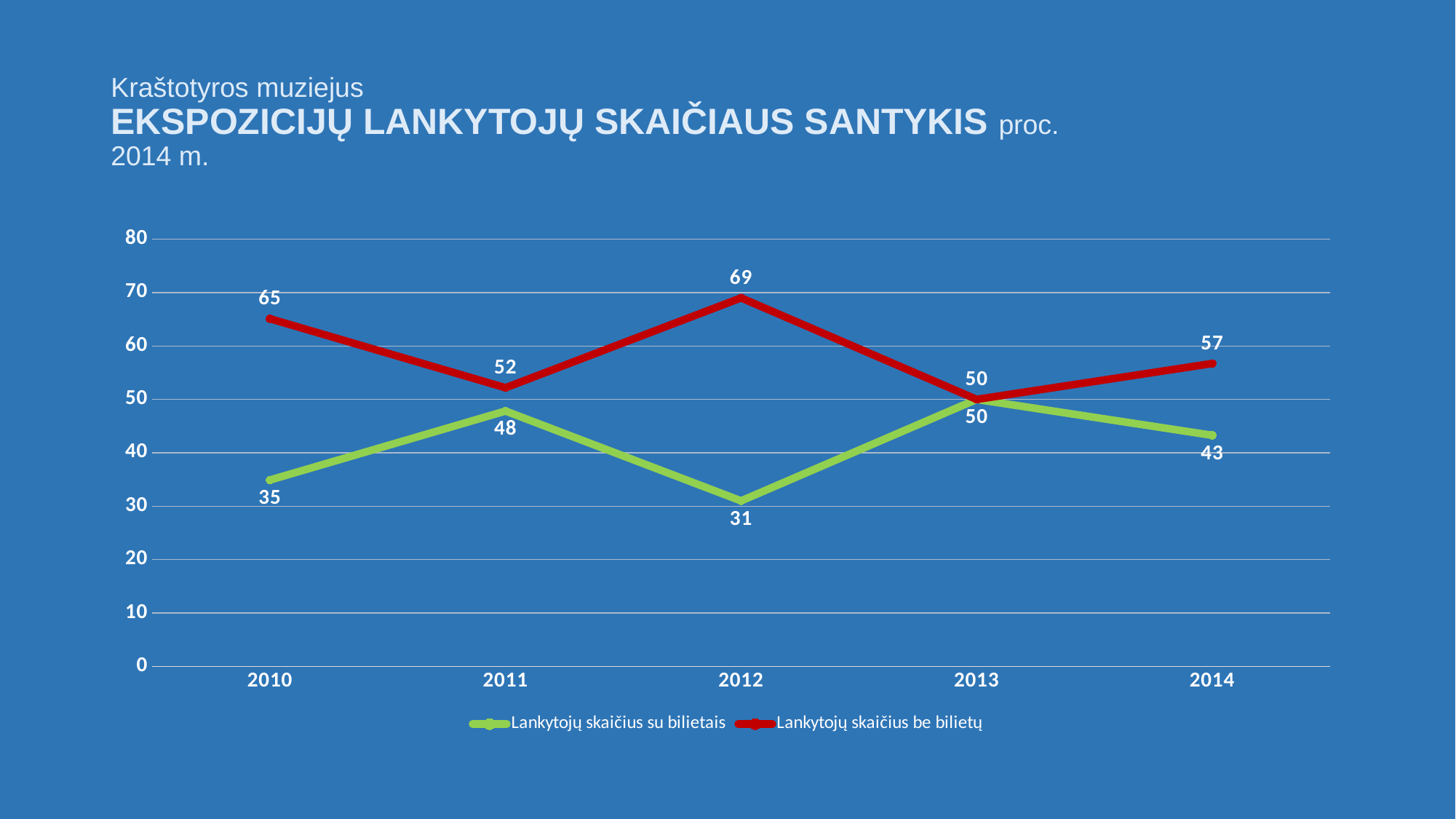
What is the difference between 'Lankytojų skaičius be bilietų' and 'Lankytojų skaičius su bilietais' in 2012? 38 What colour is the line for 'Lankytojų skaičius be bilietų'? red What is the value for 'Lankytojų skaičius su bilietais' in 2013? 50 In which year is 'Lankytojų skaičius be bilietų' highest? 2012 What is the value for 'Lankytojų skaičius su bilietais' in 2012? 31 What type of chart is shown on the slide? line chart Which is larger in 2014: 'Lankytojų skaičius su bilietais' or 'Lankytojų skaičius be bilietų'? Lankytojų skaičius be bilietų How many years are shown on the x axis? 5 What is the value for 'Lankytojų skaičius be bilietų' in 2010? 65 In which year is 'Lankytojų skaičius su bilietais' lowest? 2012 How many series does the legend list? 2 Does 'Lankytojų skaičius su bilietais' rise or fall from 2013 to 2014? fall